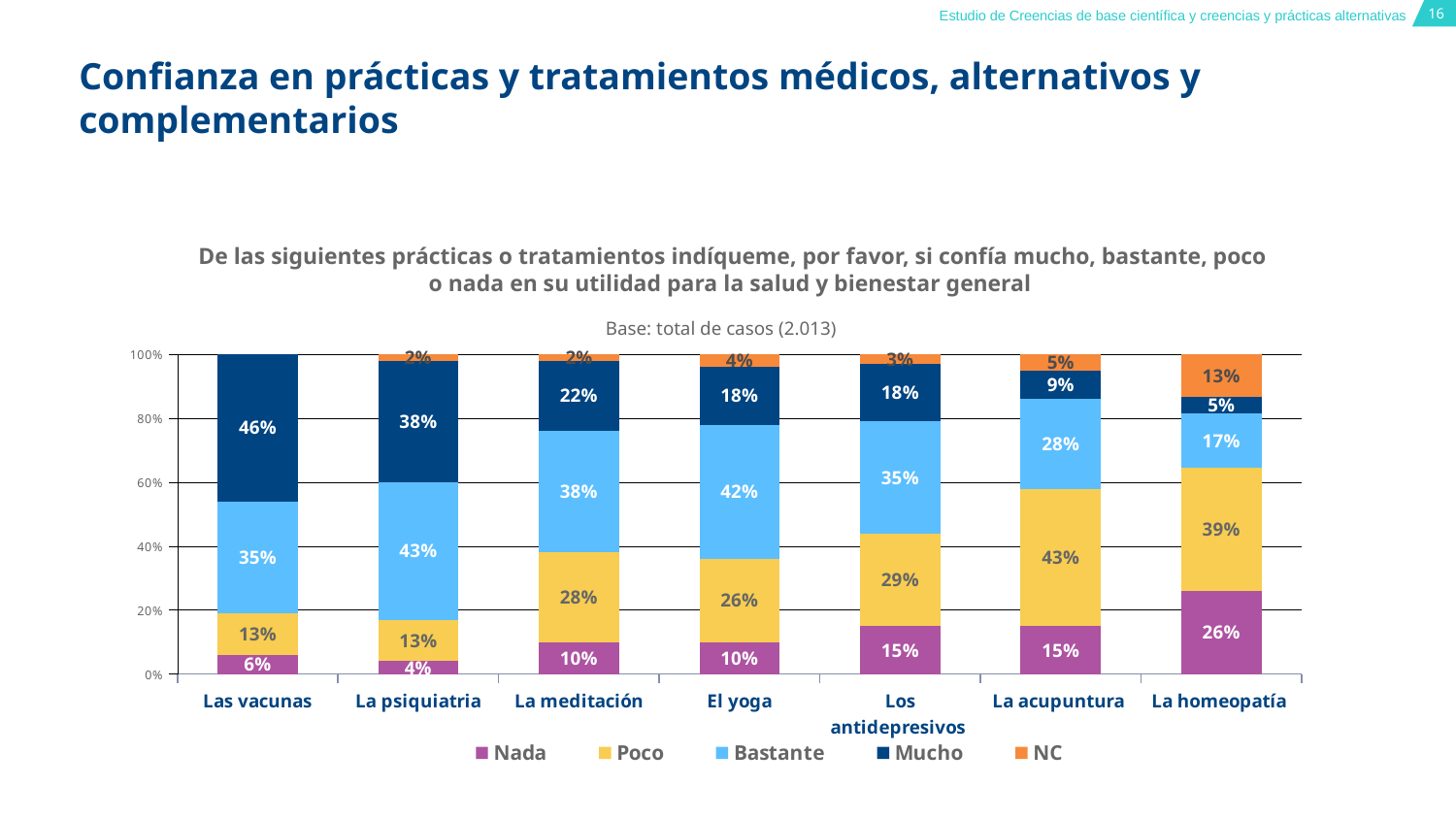
Which category has the lowest 'Mucho' value? La homeopatía What is the 'Poco' value for La acupuntura? 43% How many series does the legend list? 5 What kind of chart is shown on the slide? Stacked bar chart Which is larger: the 'Bastante' value for La psiquiatria or the 'Bastante' value for Los antidepresivos? La psiquiatria What is the 'Nada' value for La homeopatía? 26% Which colour represents the 'NC' series in the legend? Orange What is the difference between the 'Nada' value for La homeopatía and the 'Nada' value for Las vacunas? 20 percentage points What is the 'Bastante' value for El yoga? 42% How many practices or treatments (categories) are shown on the x axis? 7 What is the 'Mucho' value for Las vacunas? 46% Which category has the highest 'Mucho' value? Las vacunas